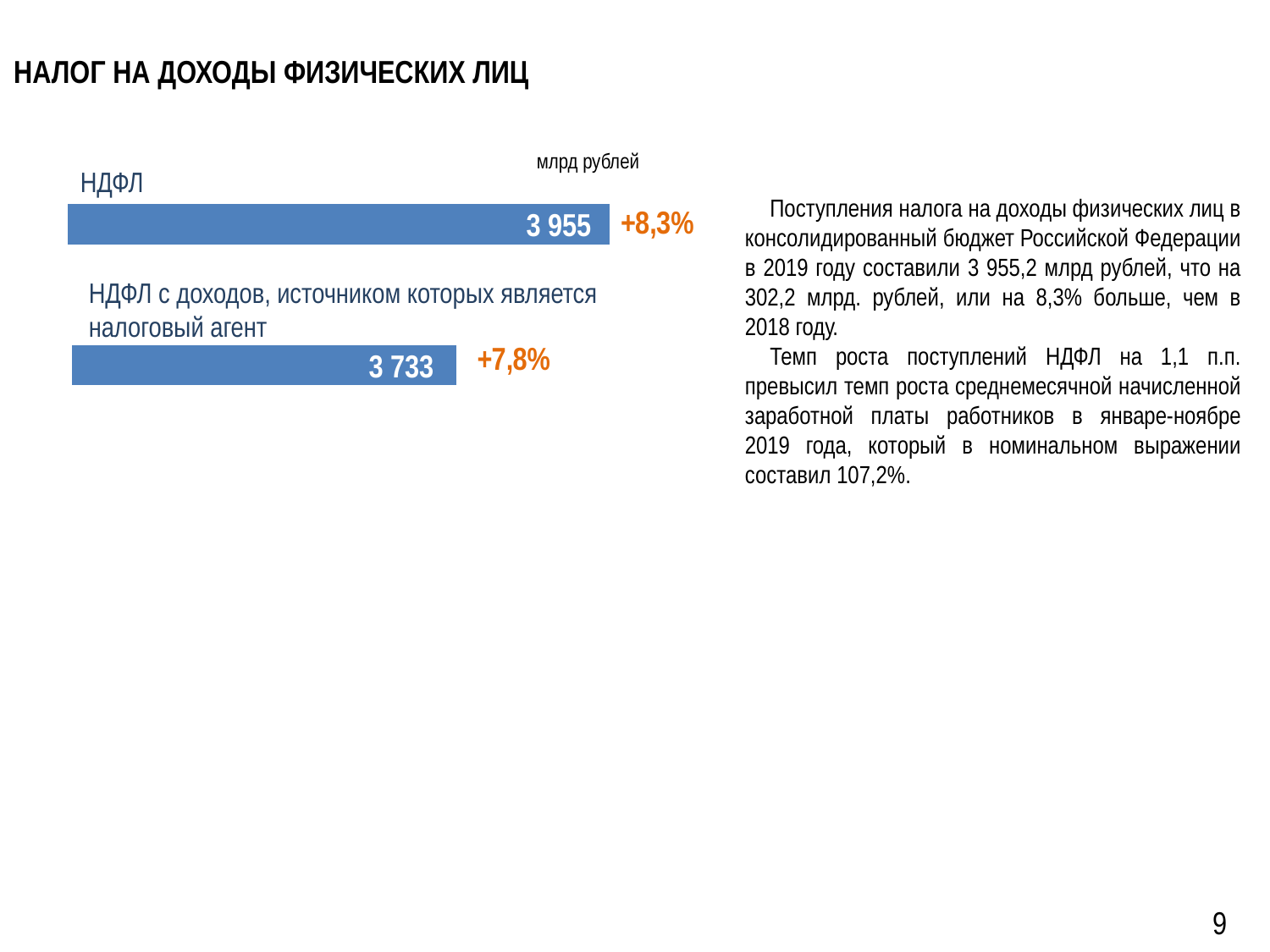
What is the value shown for НДФЛ с доходов, источником которых является налоговый агент? 3 733 Which category has the smaller bar on the chart? НДФЛ с доходов, источником которых является налоговый агент Is the value for НДФЛ larger or smaller than the value for НДФЛ с доходов, источником которых является налоговый агент? larger What growth percentage is shown next to the НДФЛ bar? +8,3% What is the value shown for НДФЛ on the chart? 3 955 What colour are the bars on the chart? blue Which category has the larger bar on the chart? НДФЛ How many bars are shown on the chart? 2 What is the difference between the НДФЛ value and the value for НДФЛ с доходов, источником которых является налоговый агент? 222 What growth percentage is shown next to the bar for НДФЛ с доходов, источником которых является налоговый агент? +7,8% In what units are the chart values given? млрд рублей What kind of chart is shown on the slide? bar chart